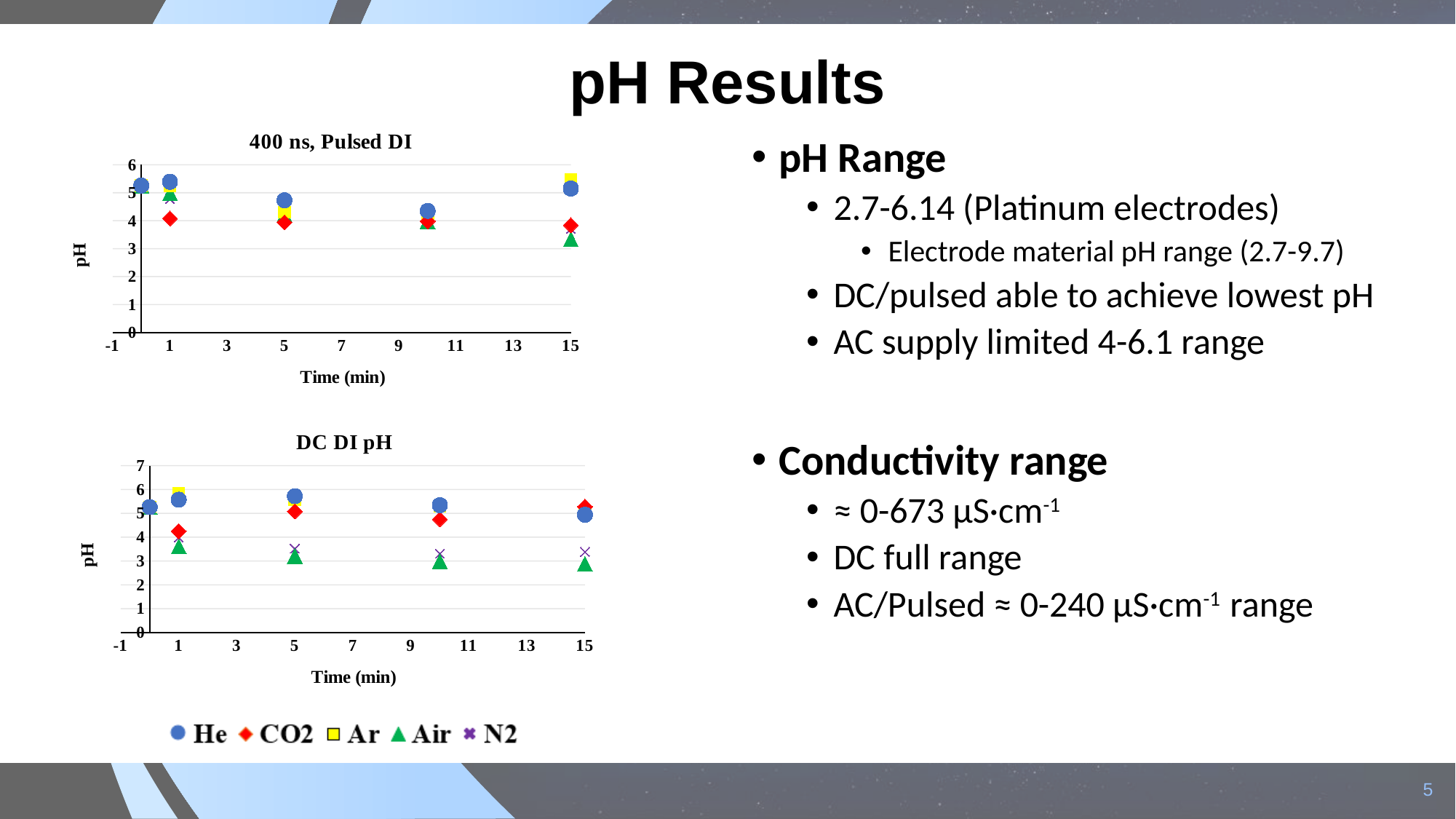
What kind of chart is the "400 ns, Pulsed DI" chart? Scatter chart In the "DC DI pH" chart, which series has the higher value at 1 min, He or Air? He In the "400 ns, Pulsed DI" chart, is the Air value at 15 min greater or less than 4? less What is the title of the top chart on the slide? 400 ns, Pulsed DI In the "DC DI pH" chart, is the He value at 5 min greater or less than 5? greater In the "DC DI pH" chart, is the Air value at 1 min greater or less than 3? greater In the "400 ns, Pulsed DI" chart, which series has the higher value at 15 min, He or Air? He How many series does the legend list for the charts? 5 What is the x-axis label of the "DC DI pH" chart? Time (min) In the "400 ns, Pulsed DI" chart, does the Air series rise or fall as time increases? Fall